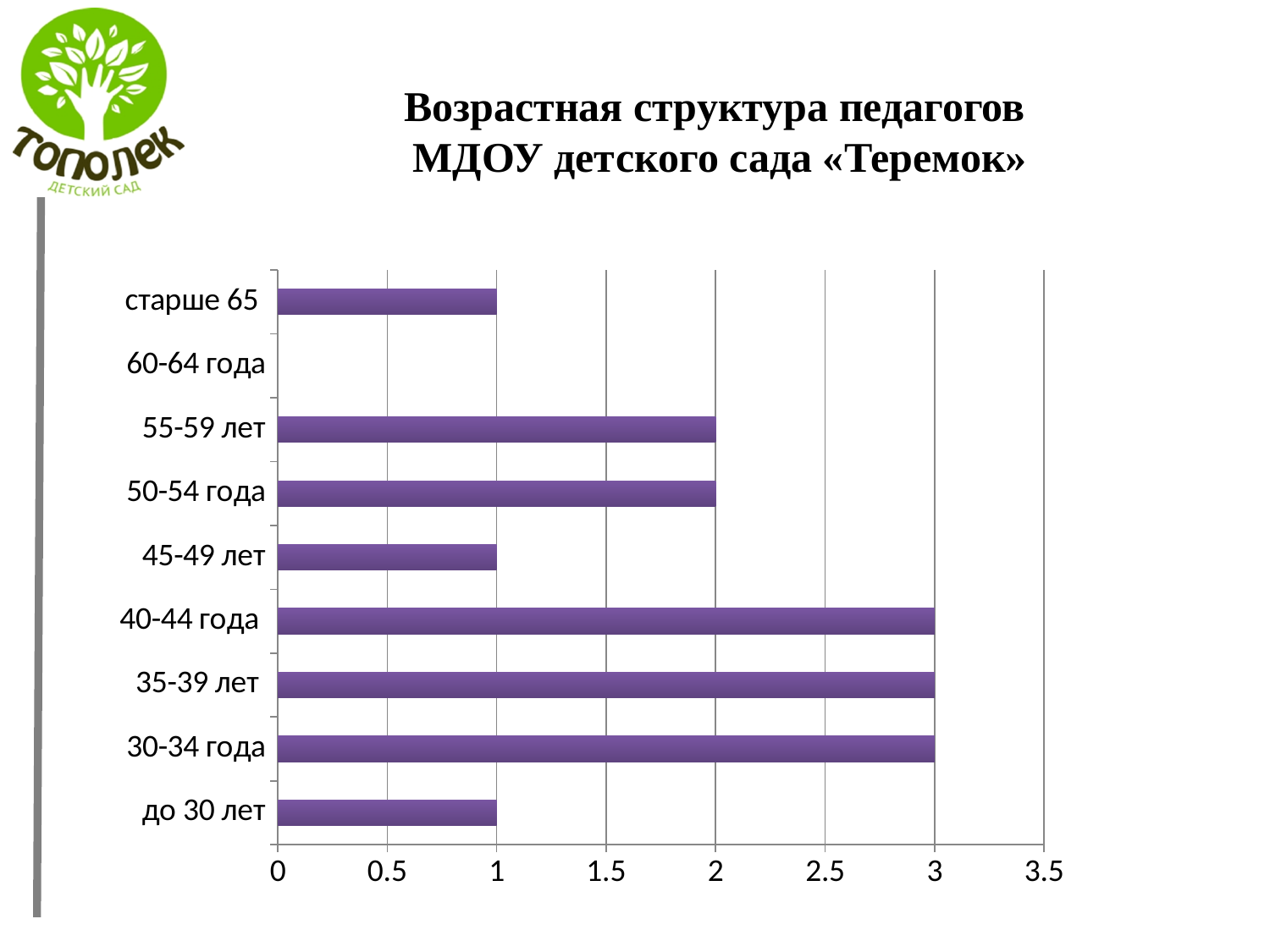
Which is larger, the value for 50-54 года or the value for 45-49 лет? 50-54 года What is the value for the 30-34 года category? 3 What kind of chart is shown on the slide? bar chart What is the difference between the values for 40-44 года and 45-49 лет? 2 What is the value for the 55-59 лет category? 2 What is the value for the старше 65 category? 1 What is the title of the chart? Возрастная структура педагогов МДОУ детского сада «Теремок» Is the value for 35-39 лет greater or less than 2? greater Which age category has the lowest value? 60-64 года How many age categories are shown on the chart? 9 What is the value for the 45-49 лет category? 1 What is the highest tick value shown on the horizontal axis? 3.5